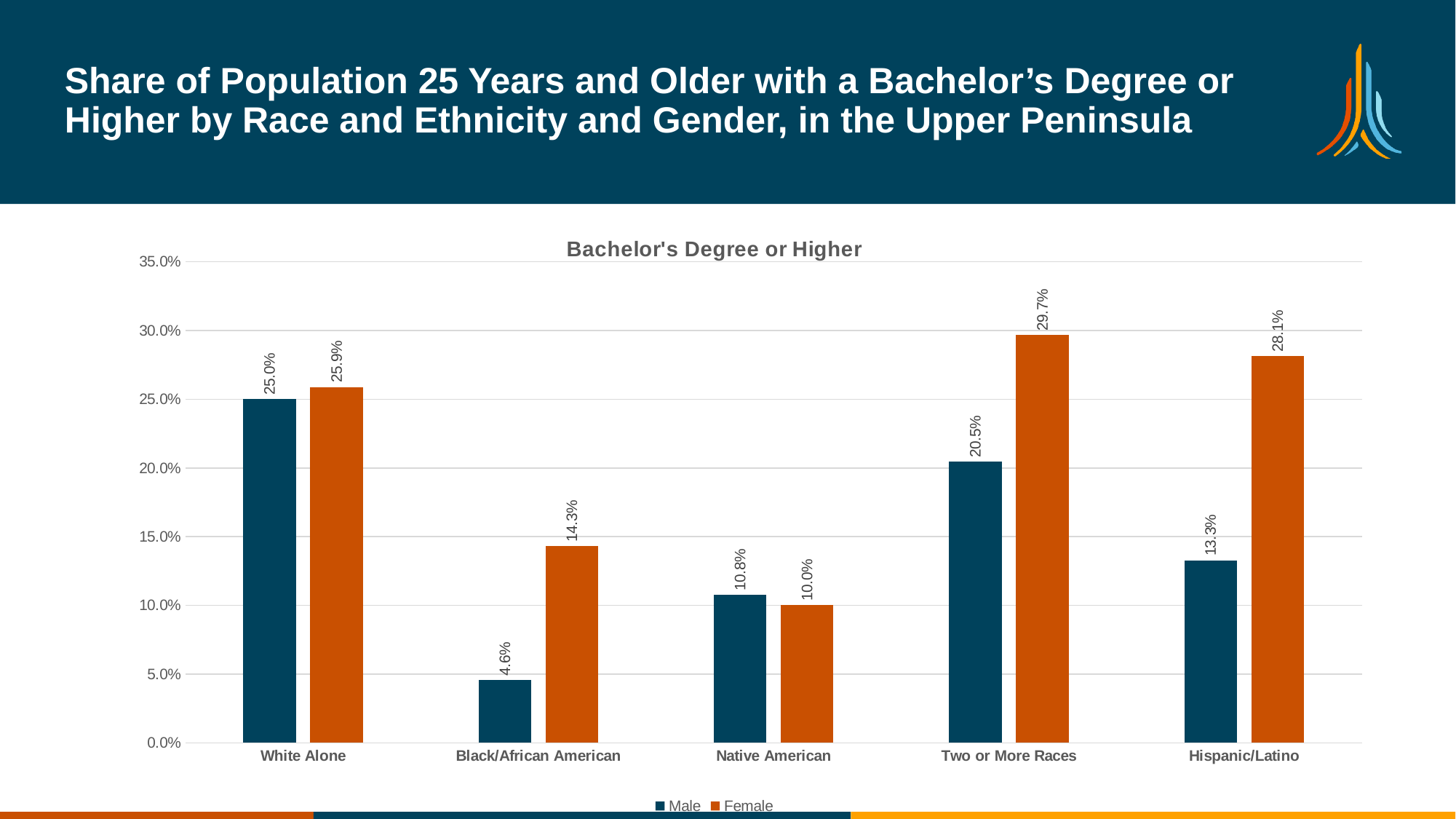
What is the Male value for Black/African American? 4.6% What is the difference between the Female and Male values for Black/African American? 9.7% What is the Female value for Two or More Races? 29.7% What is the Male value for White Alone? 25.0% Is the Male value for Hispanic/Latino greater or less than 15.0%? less Which is larger for Native American, the Male value or the Female value? Male Which category has the highest Female value? Two or More Races Which category has the lowest Male value? Black/African American How many race/ethnicity categories are shown on the x axis? 5 What is the Female value for Hispanic/Latino? 28.1% How many series does the legend list? 2 What type of chart is shown? bar chart